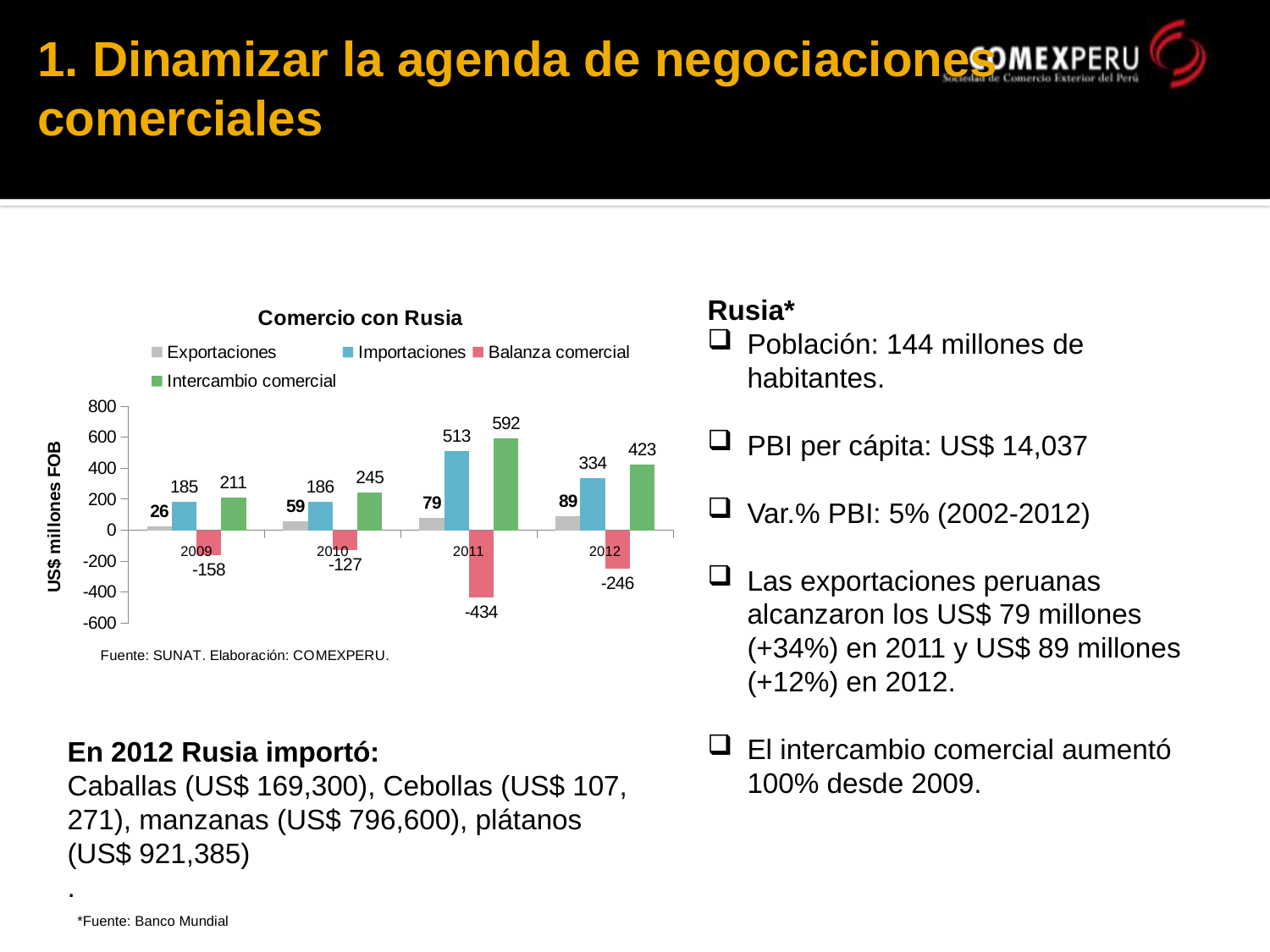
What is the value of Importaciones in 2011? 513 In which year is Exportaciones lowest? 2009 Which is larger, Intercambio comercial in 2010 or Intercambio comercial in 2012? 2012 What type of chart is shown on the slide? bar chart What is the value of Balanza comercial in 2010? -127 What is the title of the chart? Comercio con Rusia How many series does the legend list? 4 In which year is Intercambio comercial highest? 2011 What is the difference between Importaciones in 2011 and Importaciones in 2012? 179 What is the value of Exportaciones in 2012? 89 How many years are shown on the x axis? 4 Do the Exportaciones values rise or fall from 2009 to 2012? rise